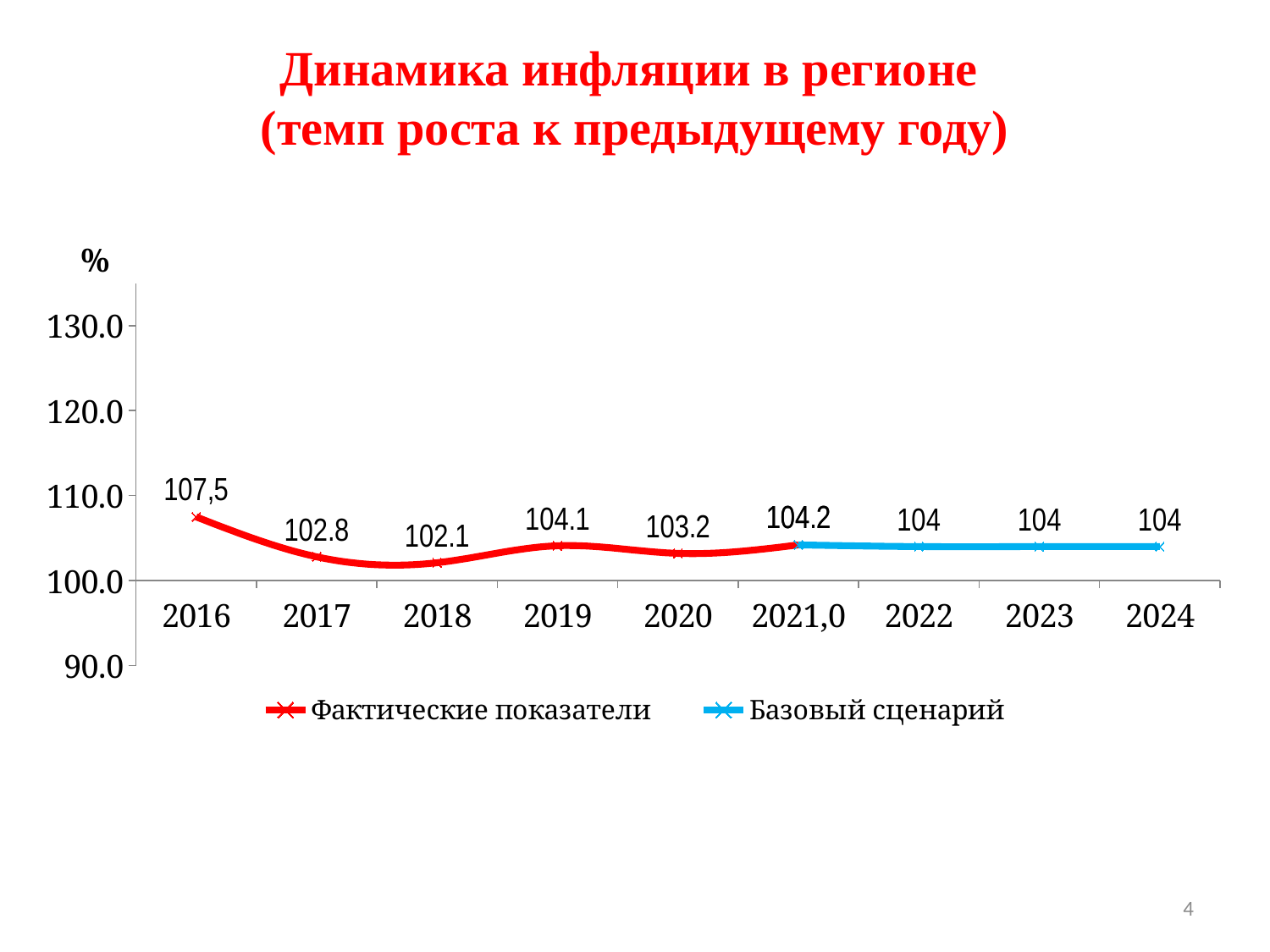
Is the value for 2016 greater or less than 110.0? less How many series does the legend list? 2 What is the value shown for 2024 in the Базовый сценарий series? 104 What is the value for 2016 on the chart? 107,5 What is the value for 2020 on the chart? 103.2 What is the value for 2019 on the chart? 104.1 What is the difference between the values for 2016 and 2017? 4.7 What kind of chart is shown on the slide? line chart Which year has the highest value on the chart? 2016 Which is larger, the value for 2019 or the value for 2020? 2019 How many years are shown on the x axis of the chart? 9 Which year has the lowest value on the chart? 2018